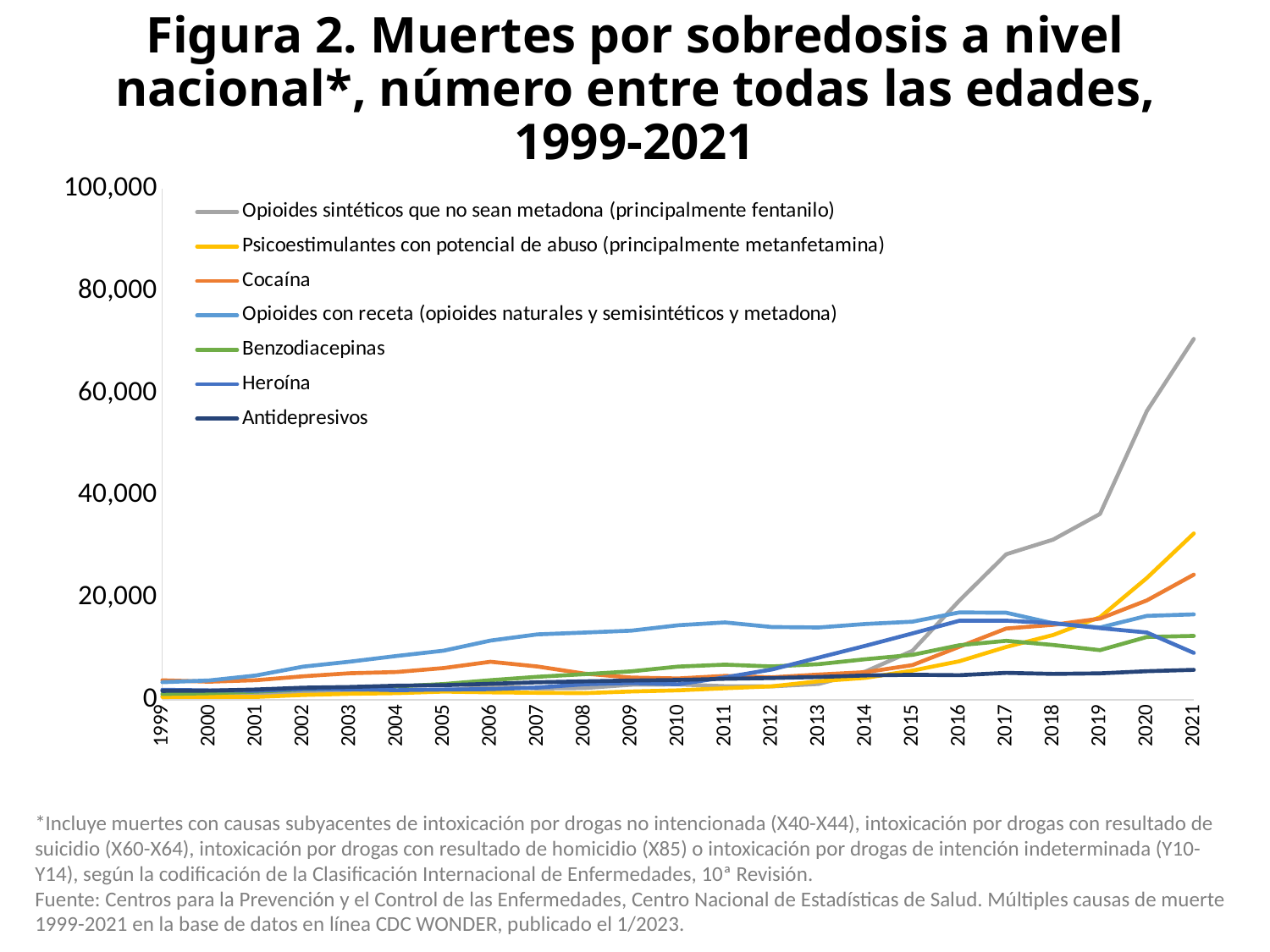
What colour is the line for Cocaína? orange Is the value for Opioides sintéticos que no sean metadona in 2021 greater or less than 60,000? greater Which series has the lowest value in 2021? Antidepresivos What kind of chart is shown on the slide? line chart Does the Opioides sintéticos que no sean metadona series rise or fall from 2015 to 2021? rise Is the value for Psicoestimulantes con potencial de abuso in 2021 greater or less than 20,000? greater In 2021, which is larger: the value for Cocaína or the value for Opioides sintéticos que no sean metadona? Opioides sintéticos que no sean metadona Which series has the highest value in 2021? Opioides sintéticos que no sean metadona (principalmente fentanilo) How many years are plotted along the x axis? 23 Which series has the highest value in 2010? Opioides con receta (opioides naturales y semisintéticos y metadona) How many series does the legend list? 7 Is the value for Heroína in 2021 greater or less than 20,000? less